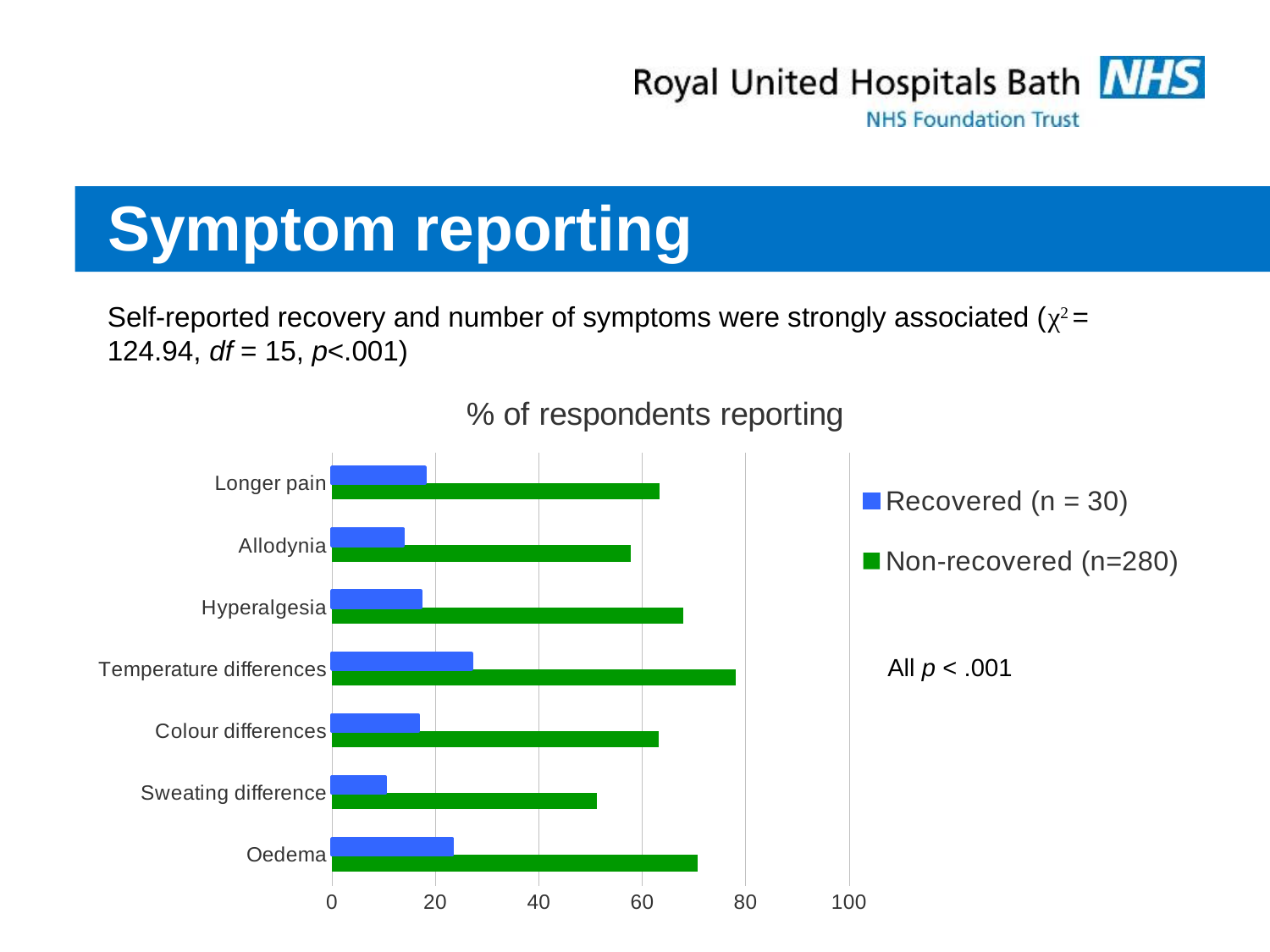
How many symptom categories are plotted on the chart? 7 Which symptom has the highest value for the Non-recovered (n=280) series? Temperature differences What kind of chart is shown on the slide? Bar chart Which series is shown in green in the chart? Non-recovered (n=280) Is the Recovered (n = 30) value for Oedema greater or less than 40? less Which symptom has the lowest value for the Recovered (n = 30) series? Sweating difference What is the title of the chart? % of respondents reporting Which symptom has the lowest value for the Non-recovered (n=280) series? Sweating difference Is the Non-recovered (n=280) value for Sweating difference greater or less than 60? less Is the Non-recovered (n=280) value for Temperature differences greater or less than 60? greater How many series does the chart legend list? 2 For the Non-recovered (n=280) series, which is larger: Hyperalgesia or Allodynia? Hyperalgesia